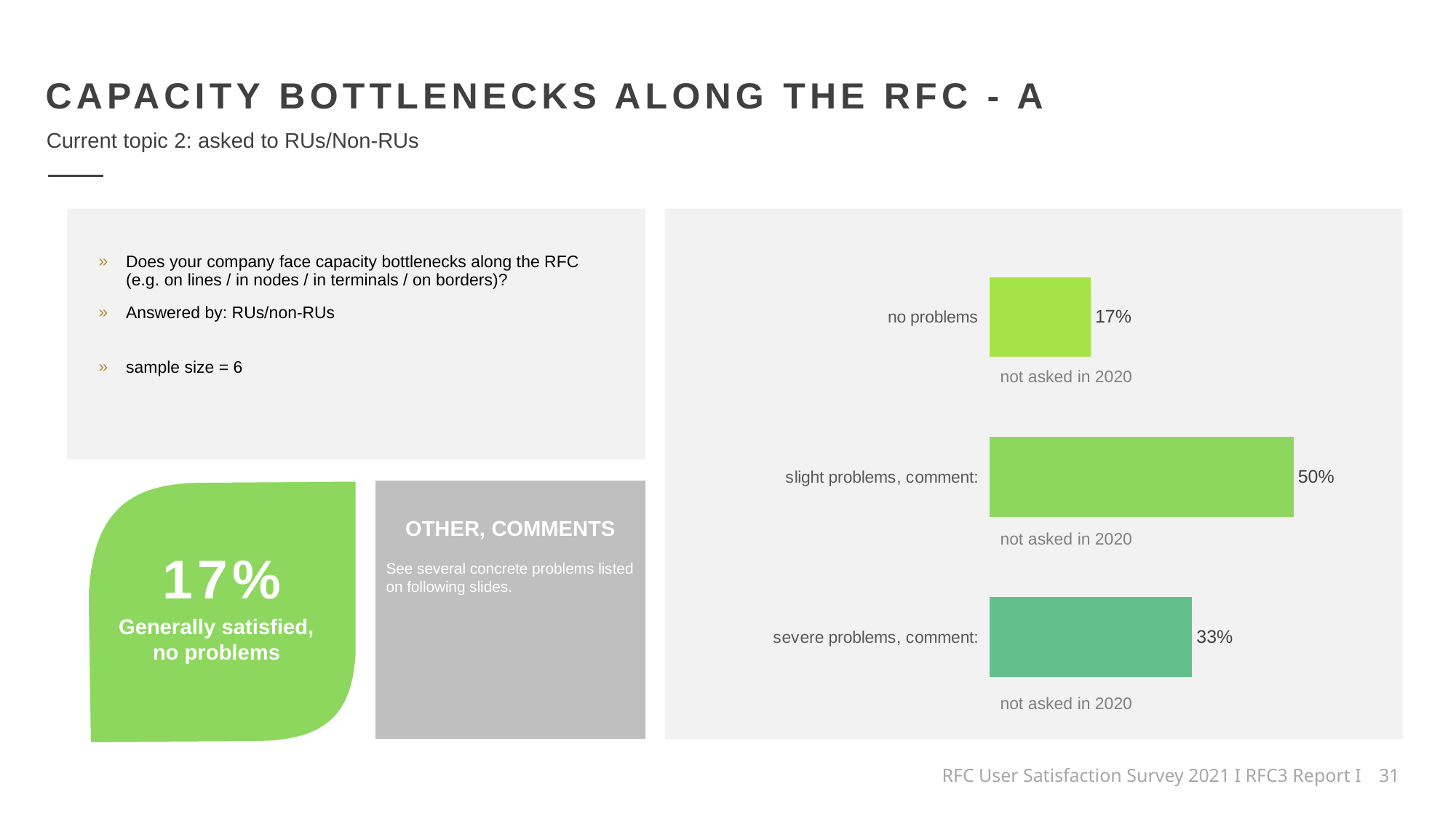
Which category has the lowest value? no problems What is the value for "no problems"? 17% What note appears under each bar in the chart? not asked in 2020 Which category has the highest value? slight problems, comment: What kind of chart is shown on the slide? bar chart What is the sample size stated on the slide? 6 Which is larger, the value for "severe problems, comment:" or the value for "no problems"? severe problems, comment: What is the value for "slight problems, comment:"? 50% What is the value for "severe problems, comment:"? 33% What is the difference between the values for "slight problems, comment:" and "severe problems, comment:"? 17% What is the difference between the values for "severe problems, comment:" and "no problems"? 16% How many categories are shown in the chart? 3